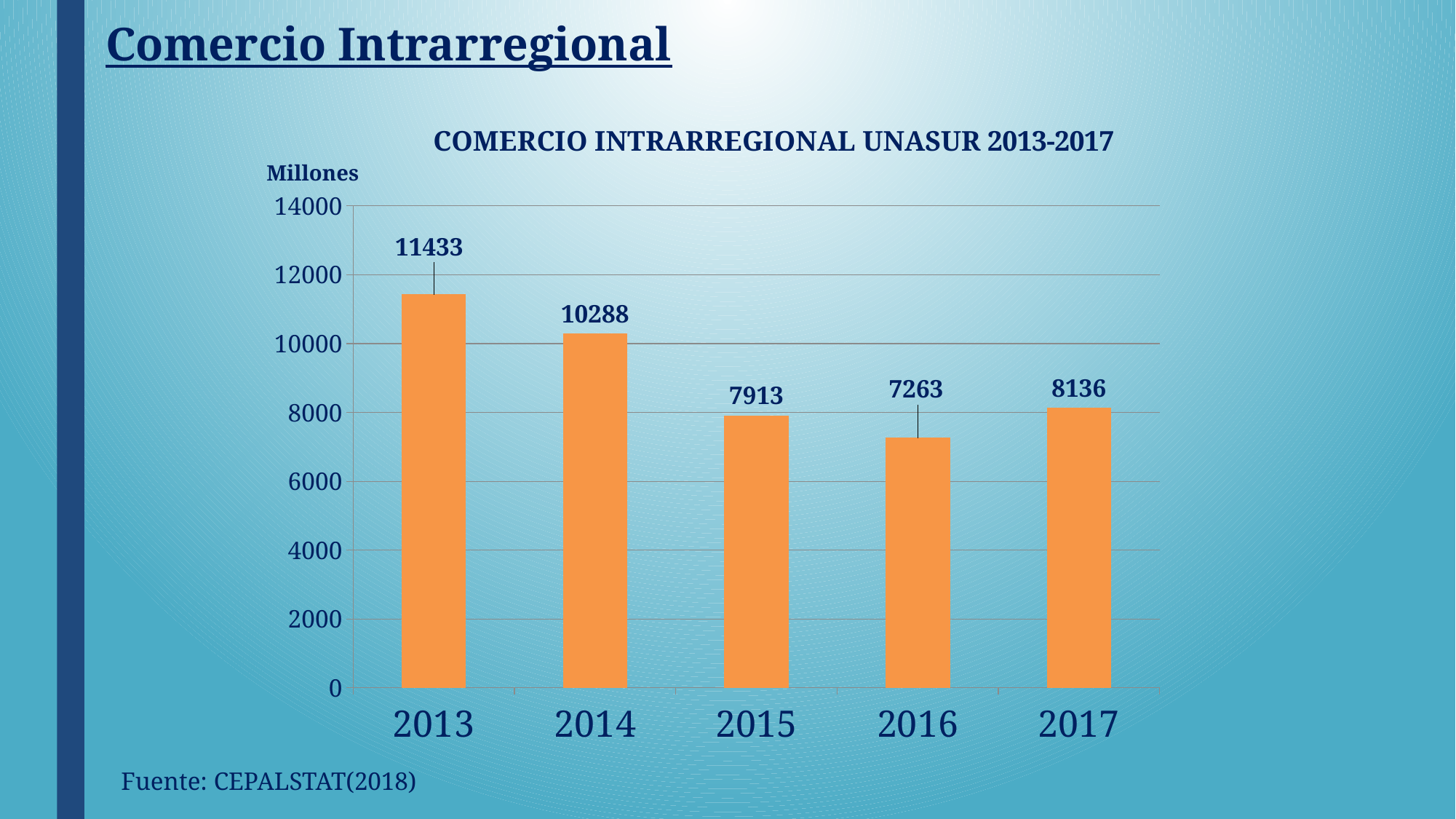
Which year has the lowest value? 2016 What is the difference between the values for 2017 and 2016? 873 What kind of chart is shown? bar chart Which is larger, the value for 2015 or the value for 2017? 2017 What is the value for 2016? 7263 What is the difference between the values for 2013 and 2014? 1145 Is the value for 2014 greater or less than 10000? greater What is the title of the chart? COMERCIO INTRARREGIONAL UNASUR 2013-2017 What is the value for 2017? 8136 How many years are shown on the x axis? 5 What is the value for 2013? 11433 Which year has the highest value? 2013